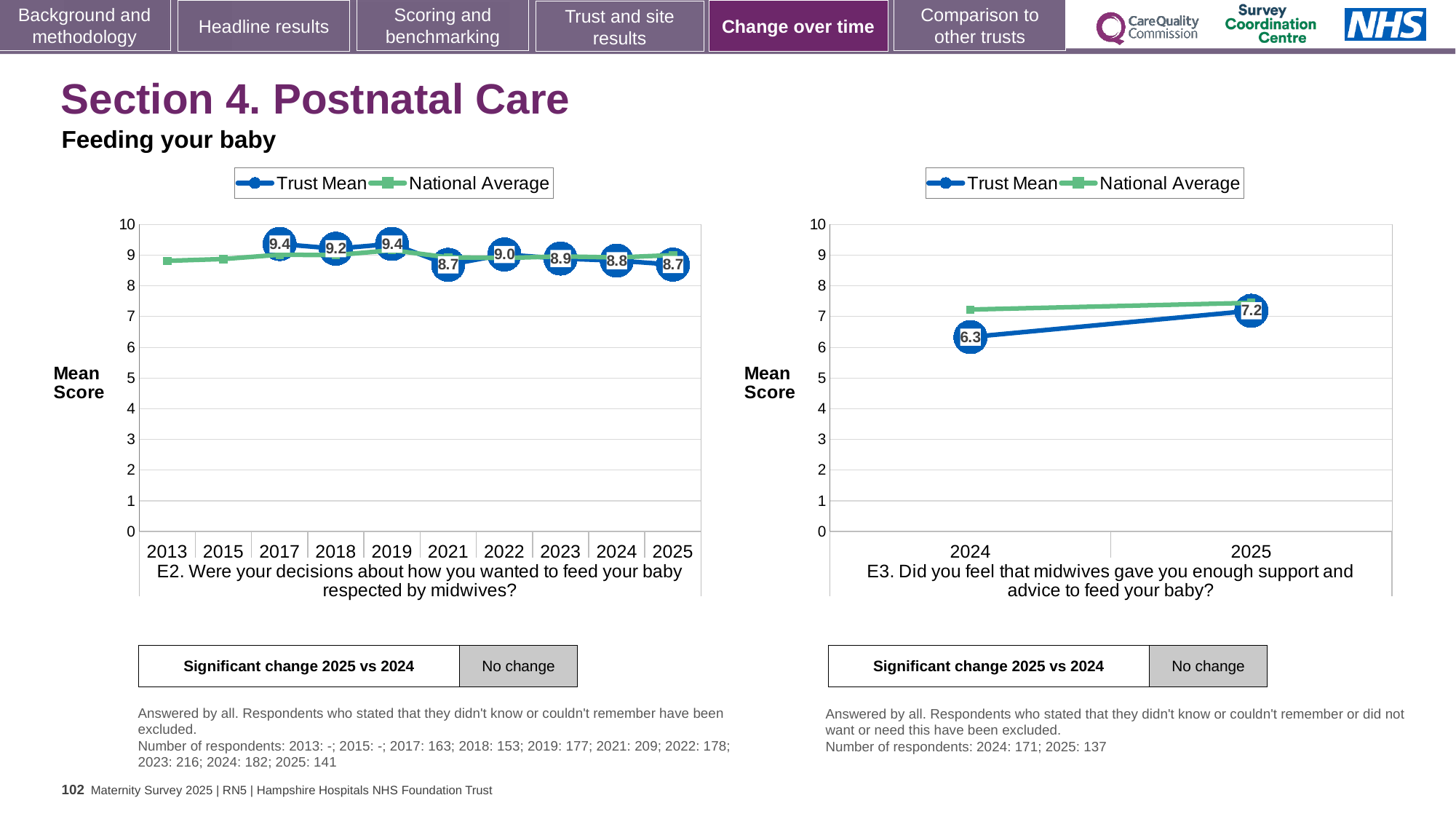
In the E3 chart on the right, is the National Average value for 2024 greater or less than 7? greater In the E2 chart on the left, what is the Trust Mean score for 2025? 8.7 What kind of chart is the E3 chart on the right? Line chart How many series does the legend of the E3 chart on the right list? 2 In the E3 chart on the right, what is the difference between the Trust Mean scores for 2025 and 2024? 0.9 In the E2 chart on the left, what is the difference between the Trust Mean scores for 2019 and 2021? 0.7 In the E2 chart on the left, which year has the lowest labelled Trust Mean score, 2018 or 2024? 2024 In the E3 chart on the right, what is the Trust Mean score for 2024? 6.3 In the E3 chart on the right, what is the Trust Mean score for 2025? 7.2 In the E2 chart on the left, what is the Trust Mean score for 2022? 9.0 How many years are shown on the x axis of the E2 chart on the left? 10 In the E2 chart on the left, what is the Trust Mean score for 2021? 8.7